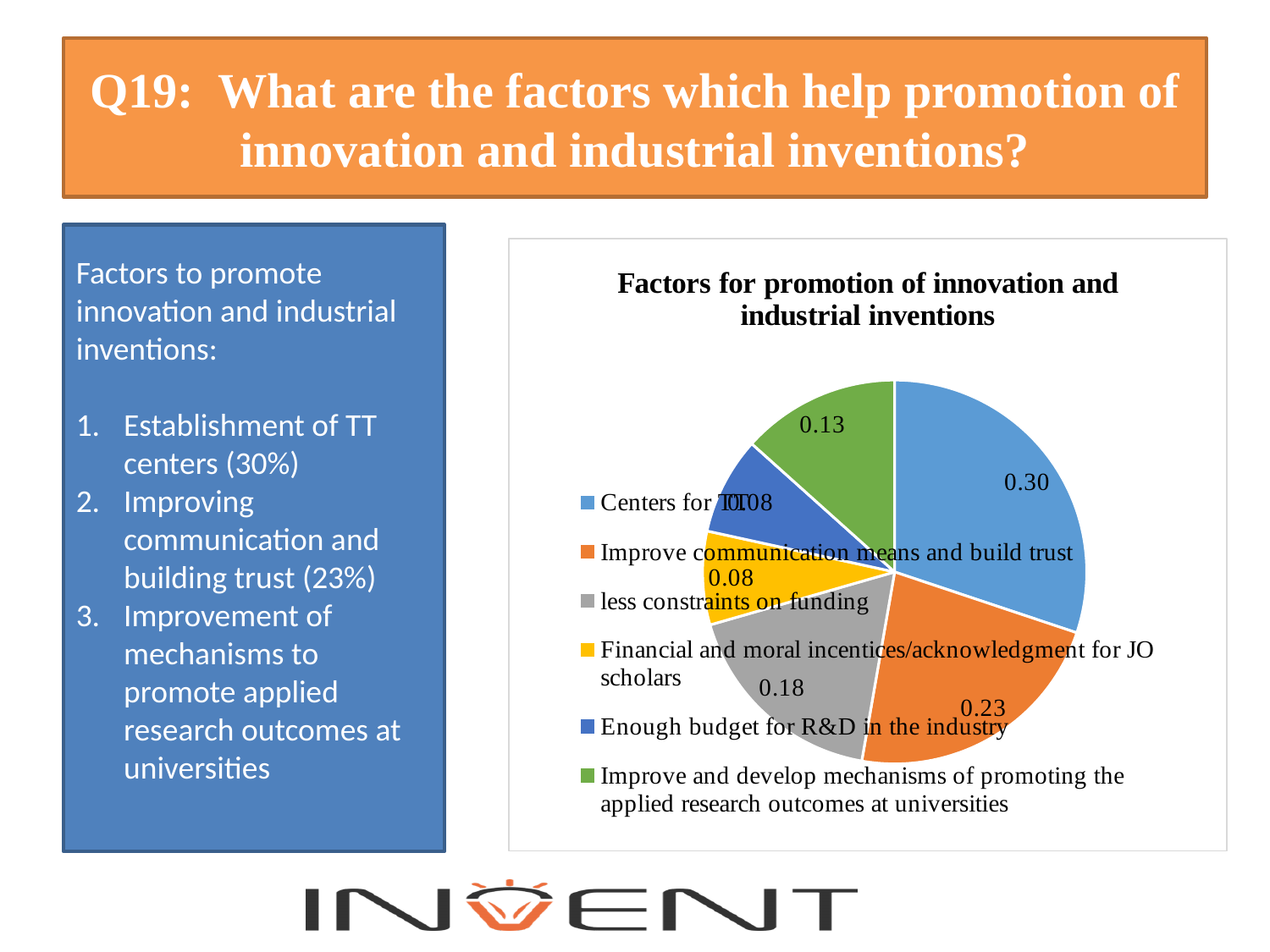
What is the title of the chart? Factors for promotion of innovation and industrial inventions How many slices does the pie chart have? 6 What is the difference between the values for 'Centers for TT' and 'Improve communication means and build trust'? 0.07 What value is shown for the 'Centers for TT' slice? 0.30 What colour is the 'Centers for TT' slice? blue What value is shown for 'Financial and moral incentives/acknowledgment for JO scholars'? 0.08 What value is shown for 'less constraints on funding'? 0.18 Which is larger: 'less constraints on funding' or 'Improve and develop mechanisms of promoting the applied research outcomes at universities'? less constraints on funding What value is shown for 'Improve and develop mechanisms of promoting the applied research outcomes at universities'? 0.13 What kind of chart is shown on the slide? pie chart What value is shown for 'Improve communication means and build trust'? 0.23 Which factor has the largest slice of the pie? Centers for TT